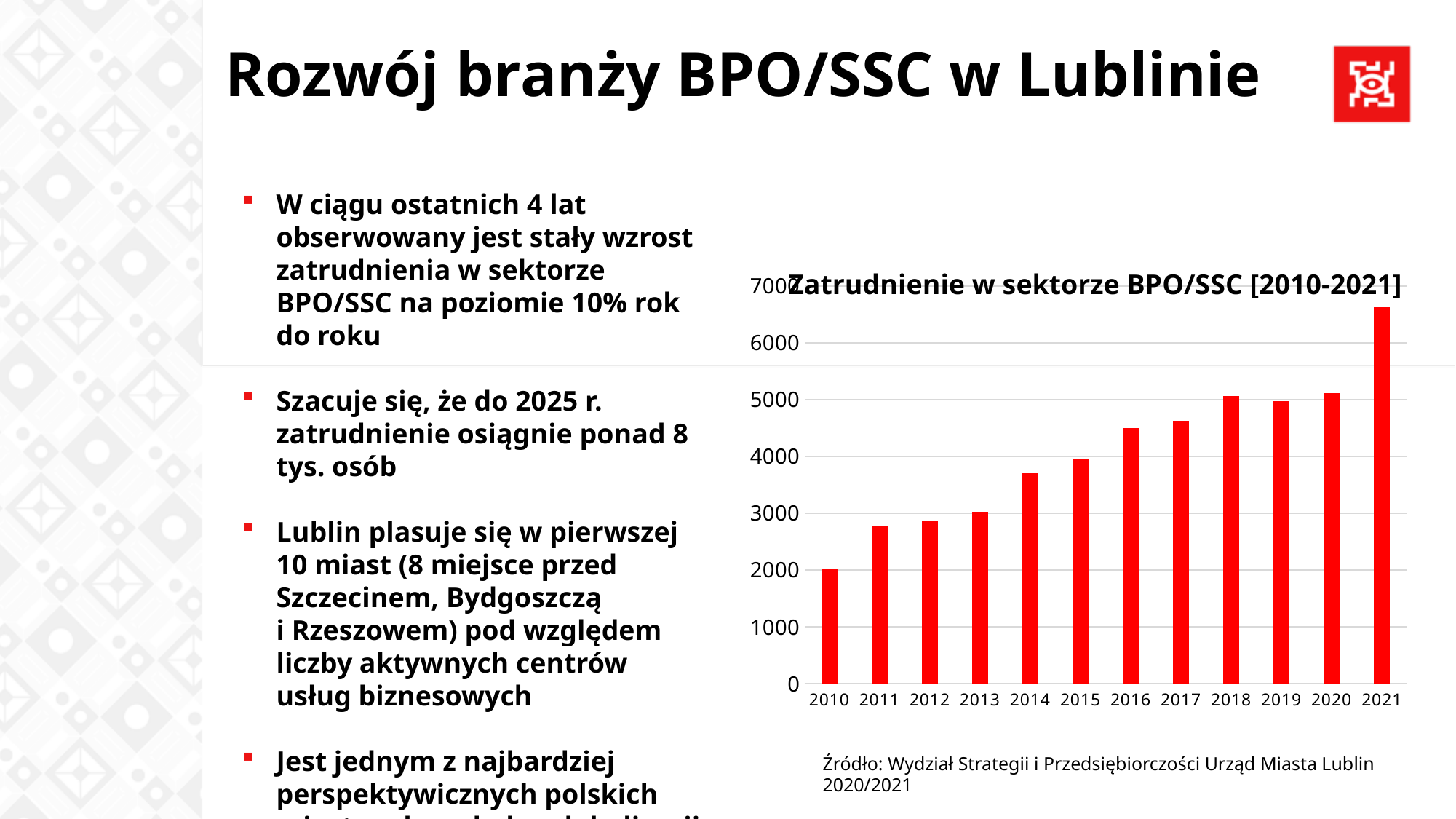
Which year has the lowest employment value in the chart? 2010 Is the value for 2014 greater or less than 4000? less Is the value for 2016 greater or less than 4000? greater How many years are shown on the x axis of the chart? 12 Is the value for 2021 greater or less than 6000? greater Do the values generally rise or fall from 2010 to 2021? rise Which year has the highest employment value in the chart? 2021 What kind of chart is shown on the slide? bar chart What is the title of the chart? Zatrudnienie w sektorze BPO/SSC [2010-2021] Which year has a larger value, 2016 or 2013? 2016